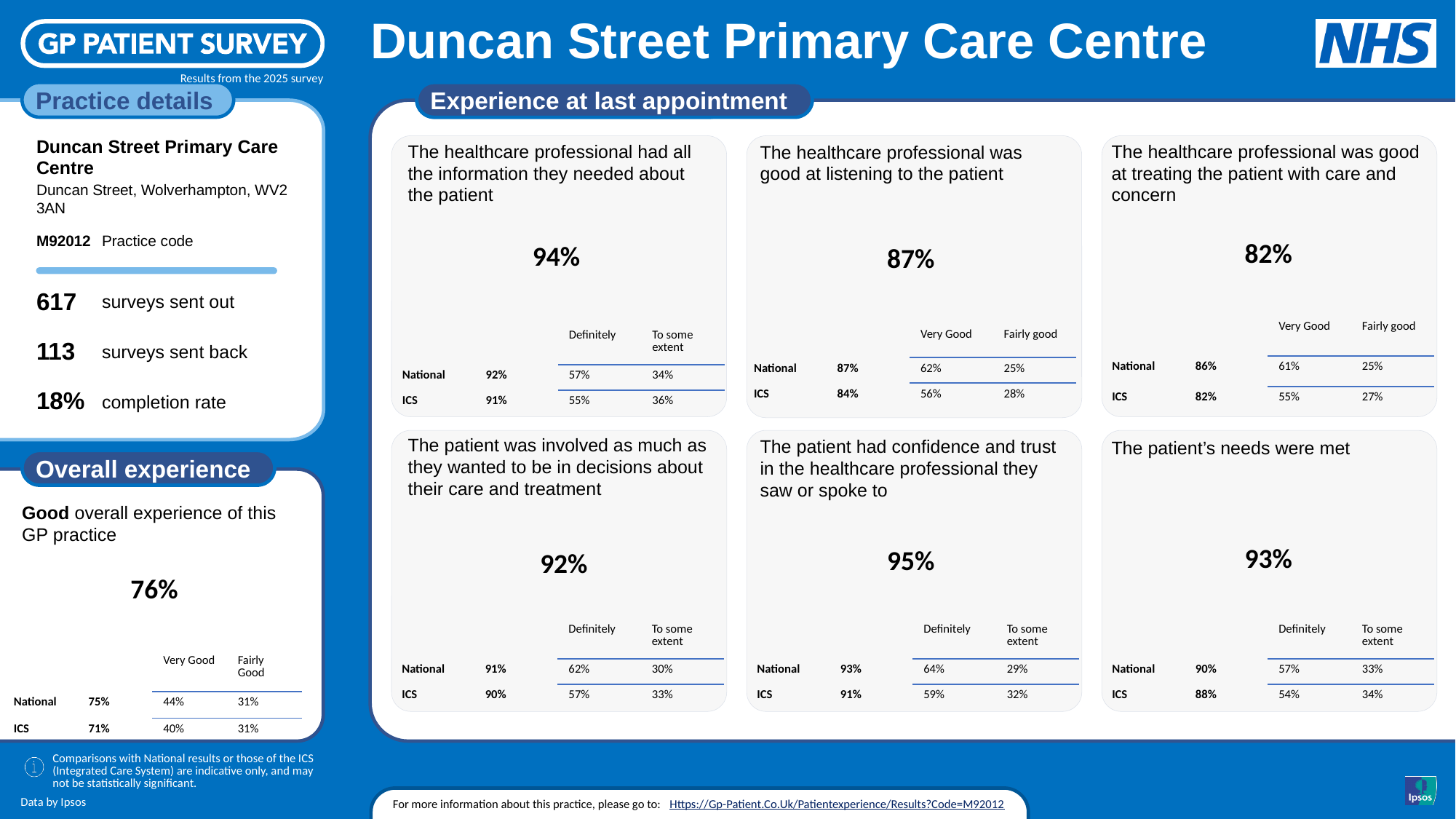
In the 'Overall experience' panel, what is the National figure for good overall experience? 75% In the 'Experience at last appointment' section, how many percentage points higher is the practice's 94% for 'had all the information they needed' than the ICS figure of 91%? 3 percentage points In the 'Experience at last appointment' section, which statement has the highest practice percentage? The patient had confidence and trust in the healthcare professional they saw or spoke to (95%) In the 'Overall experience' panel, what percentage of patients reported a good overall experience of this GP practice? 76% In the 'Experience at last appointment' section, what percentage is shown for 'The healthcare professional had all the information they needed about the patient'? 94% In the 'Experience at last appointment' section, what percentage is shown for 'The healthcare professional was good at listening to the patient'? 87% In the 'Experience at last appointment' section, what percentage is shown for 'The patient's needs were met'? 93% In the 'Experience at last appointment' section, what is the National figure for 'The patient had confidence and trust in the healthcare professional they saw or spoke to'? 93% In the 'Experience at last appointment' section, is the practice's 87% for 'good at listening to the patient' higher or lower than the ICS figure of 84%? higher In the 'Experience at last appointment' section, what is the ICS figure for 'The healthcare professional was good at treating the patient with care and concern'? 82% In the 'Experience at last appointment' section, which statement has the lowest practice percentage? The healthcare professional was good at treating the patient with care and concern (82%) How many statements are shown in the 'Experience at last appointment' section? 6